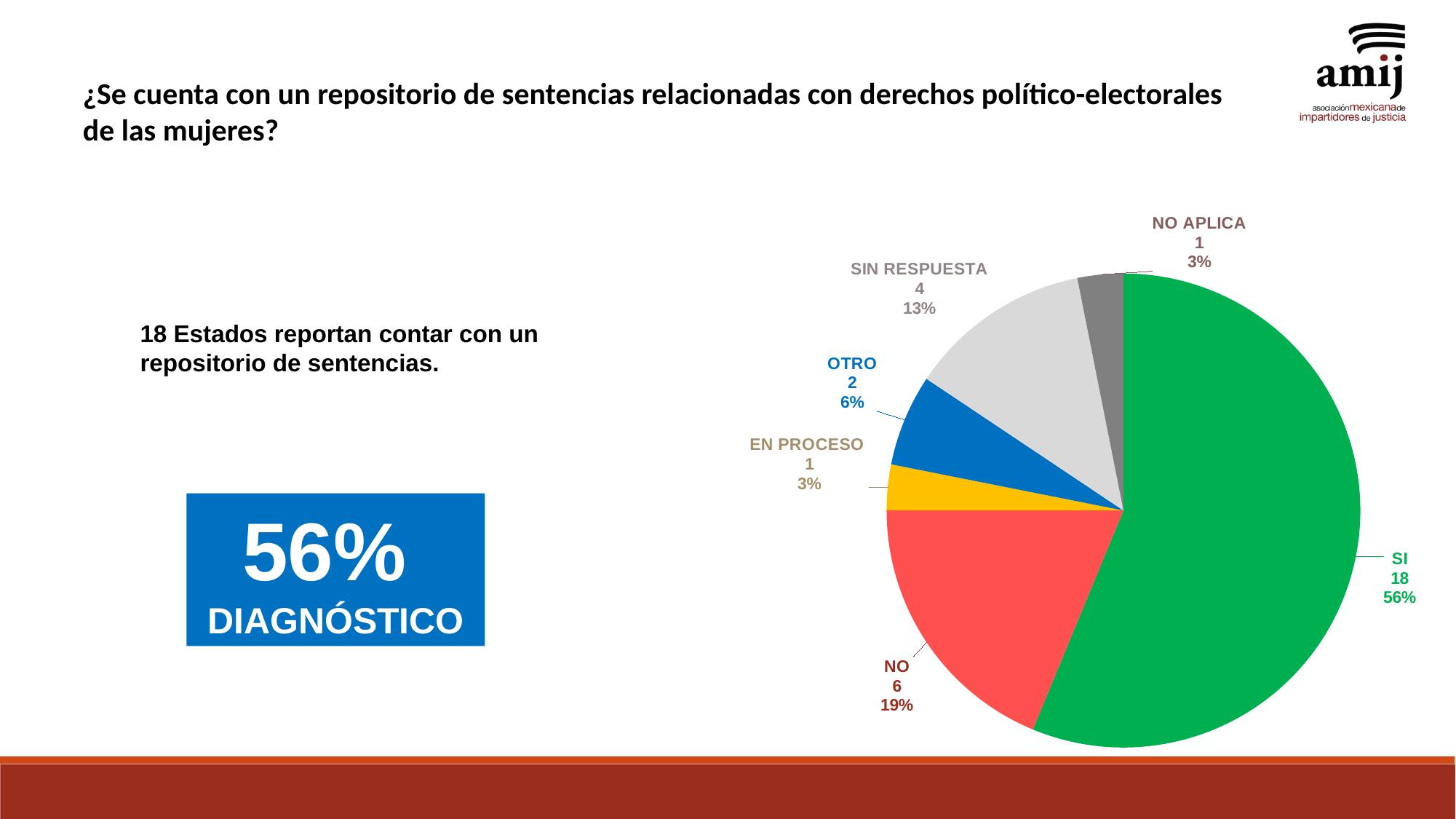
What is the count for the SI slice? 18 What is the count for SIN RESPUESTA? 4 What percentage share does the EN PROCESO slice have? 3% Which category has the largest slice? SI What colour is the SI slice? green What percentage share does the NO slice have? 19% What is the difference between the counts for SI and NO? 12 Which is larger, the count for SIN RESPUESTA or the count for OTRO? SIN RESPUESTA What kind of chart is shown on the slide? pie chart What is the total count across all slices of the pie chart? 32 How many slices does the pie chart have? 6 What percentage share does the OTRO slice have? 6%